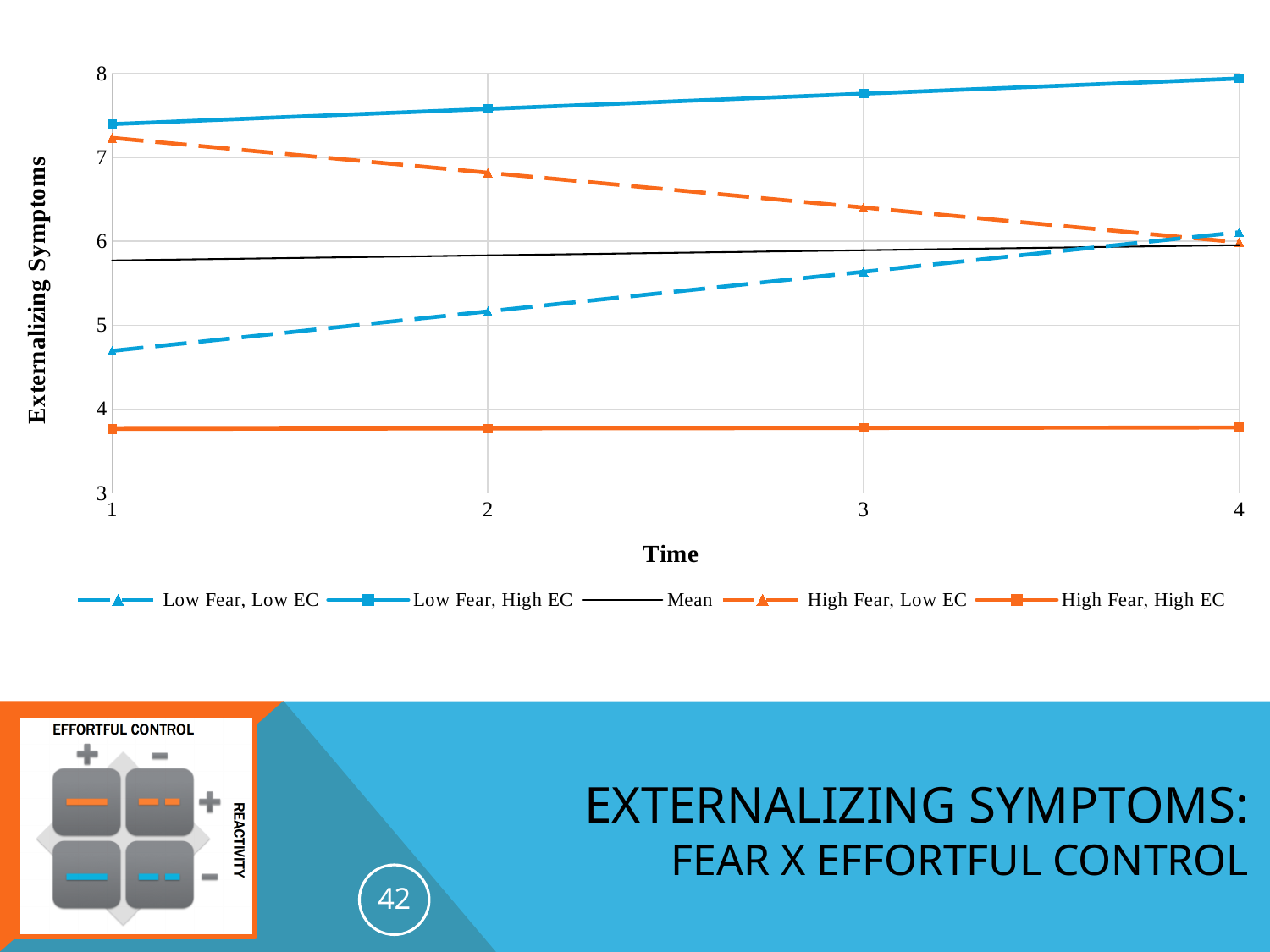
Which series has the highest value at Time 4? Low Fear, High EC Which series has the lowest value at Time 1? High Fear, High EC What is the title of the y axis? Externalizing Symptoms At Time 2, which is larger: High Fear, Low EC or Low Fear, Low EC? High Fear, Low EC Is the value for Low Fear, Low EC at Time 1 greater or less than 5? less Is the value for Low Fear, High EC at Time 3 greater or less than 7? greater How many time points are plotted along the x axis? 4 Does the Low Fear, High EC line rise or fall from Time 1 to Time 4? rise What kind of chart is shown on the slide? line chart Does the Low Fear, Low EC line rise or fall over time? rise Does the High Fear, Low EC line rise or fall from Time 1 to Time 4? fall How many series does the legend list? 5